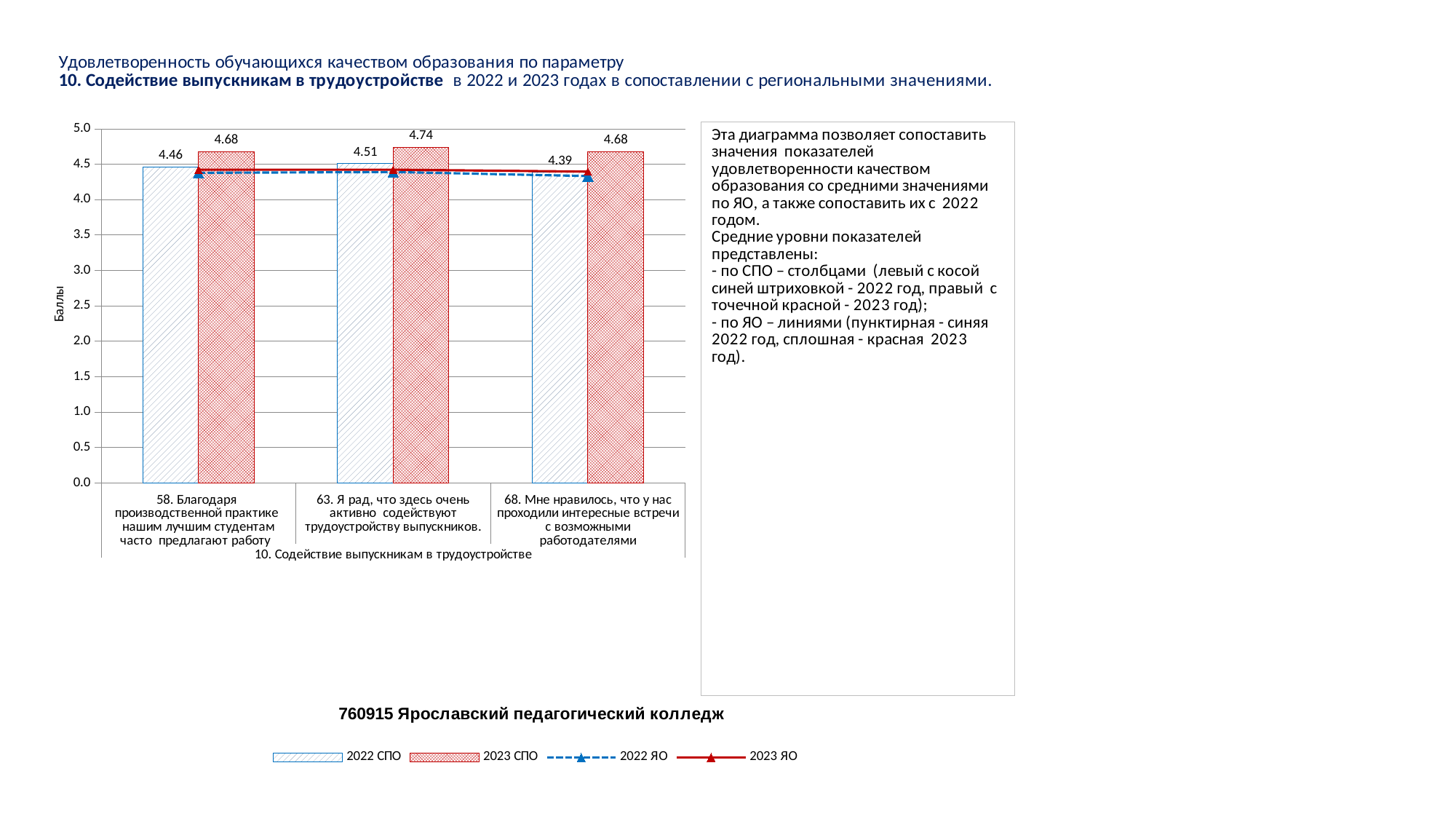
How many series does the legend list? 4 How many categories are shown on the x axis? 3 What is the difference between the 2023 СПО and 2022 СПО values for category 68? 0.29 For category 58, which is larger: the 2022 СПО value or the 2023 СПО value? 2023 СПО What is the 2023 СПО value for category 63 (Я рад, что здесь очень активно содействуют трудоустройству выпускников)? 4.74 Which category has the lowest 2022 СПО value? 68. Мне нравилось, что у нас проходили интересные встречи с возможными работодателями What kind of chart is used for the СПО series? bar chart What is the 2022 СПО value for category 58 (Благодаря производственной практике нашим лучшим студентам часто предлагают работу)? 4.46 Is the 2022 ЯО value for category 63 greater or less than 4.0? greater What is the 2023 СПО value for category 68 (Мне нравилось, что у нас проходили интересные встречи с возможными работодателями)? 4.68 Which category has the highest 2023 СПО value? 63. Я рад, что здесь очень активно содействуют трудоустройству выпускников What is the label of the vertical axis? Баллы